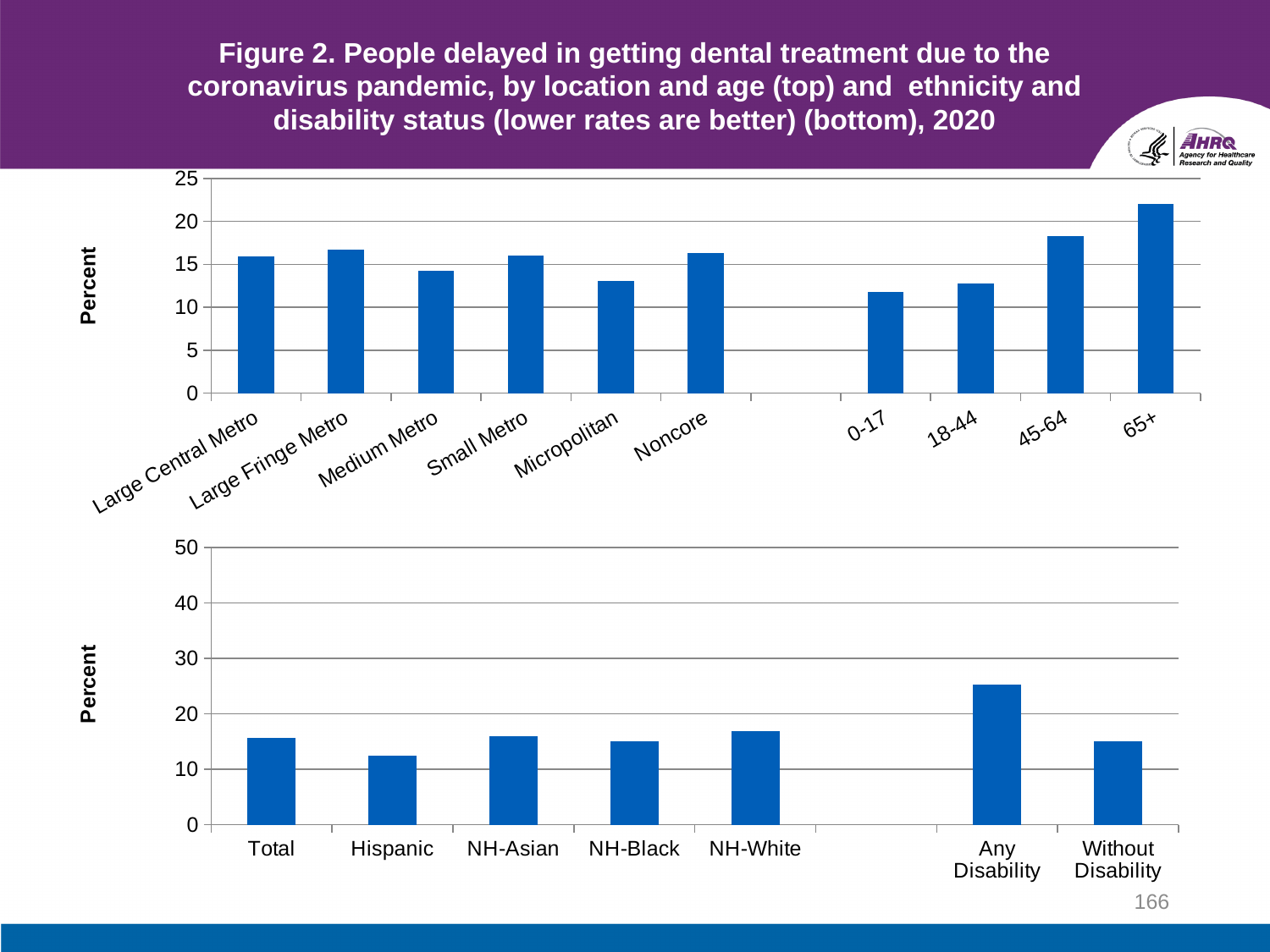
In the top chart, which category has the lowest value? 0-17 In the top chart, is the value for 65+ greater or less than 20? greater In the bottom chart, which is larger, the value for Hispanic or the value for NH-White? NH-White In the top chart, which category has the highest value? 65+ In the bottom chart, which category has the highest value? Any Disability In the bottom chart, which category has the lowest value? Hispanic In the top chart, is the value for Micropolitan greater or less than 15? less What kind of chart is the bottom chart? bar chart How many categories are plotted in the top chart? 10 In the top chart, which is larger, the value for Micropolitan or the value for Noncore? Noncore In the bottom chart, is the value for Any Disability greater or less than 20? greater In the top chart, do the values rise or fall across the age groups from 0-17 to 65+? rise